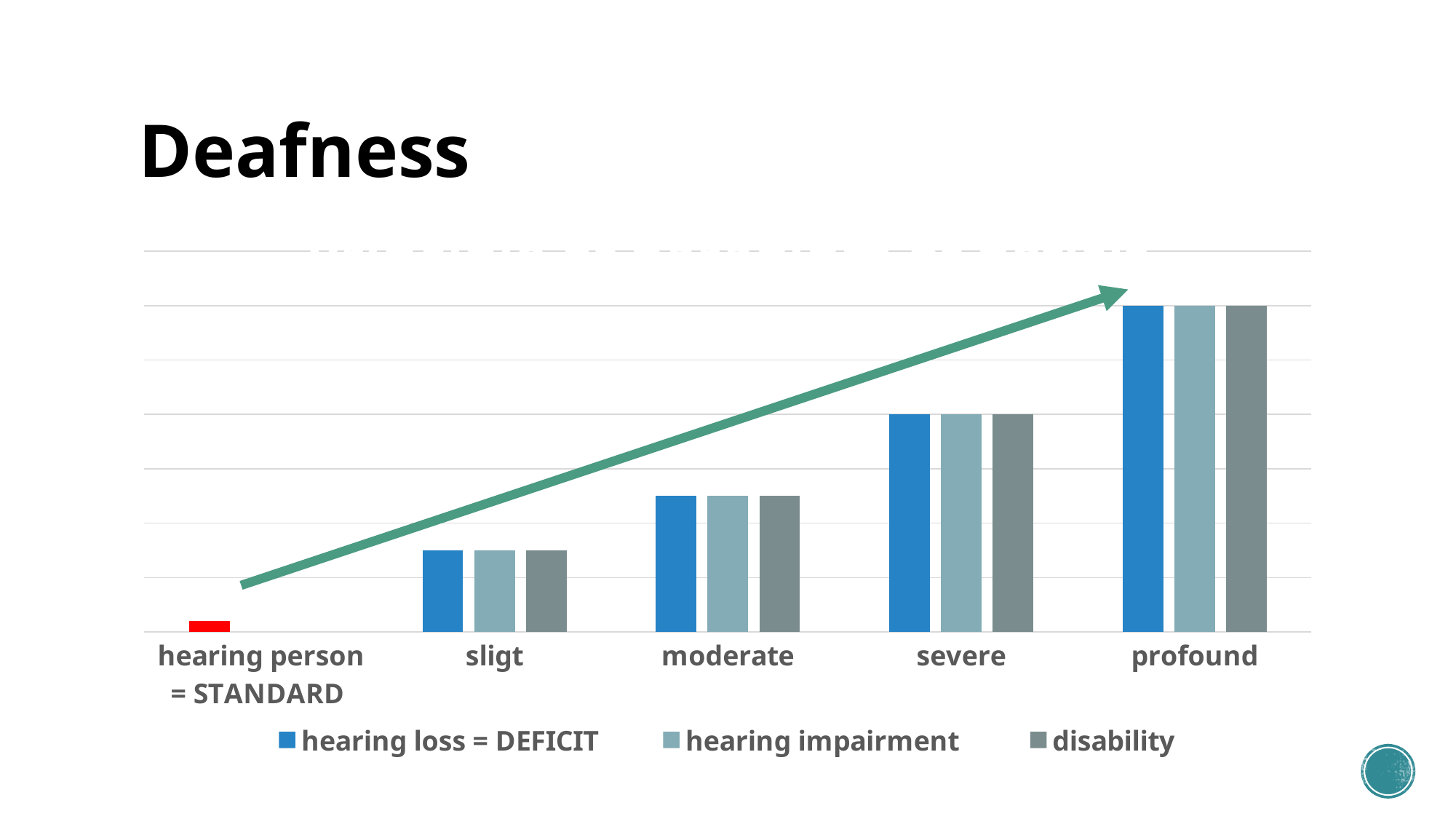
What is the first series listed in the chart's legend? hearing loss = DEFICIT What kind of chart is shown on the slide? bar chart How many categories are shown along the x axis of the chart? 5 How many series does the chart's legend list? 3 Which is larger, the 'disability' bar for sligt or for profound? profound Which category has the tallest bars in the chart? profound What colour is the bar for the 'hearing person = STANDARD' category? red Which is larger, the 'hearing impairment' bar for moderate or for sligt? moderate Do the bar heights rise or fall moving from left to right along the x axis? rise Which is larger, the 'hearing loss = DEFICIT' bar for severe or for moderate? severe Which category has the lowest bar in the chart? hearing person = STANDARD